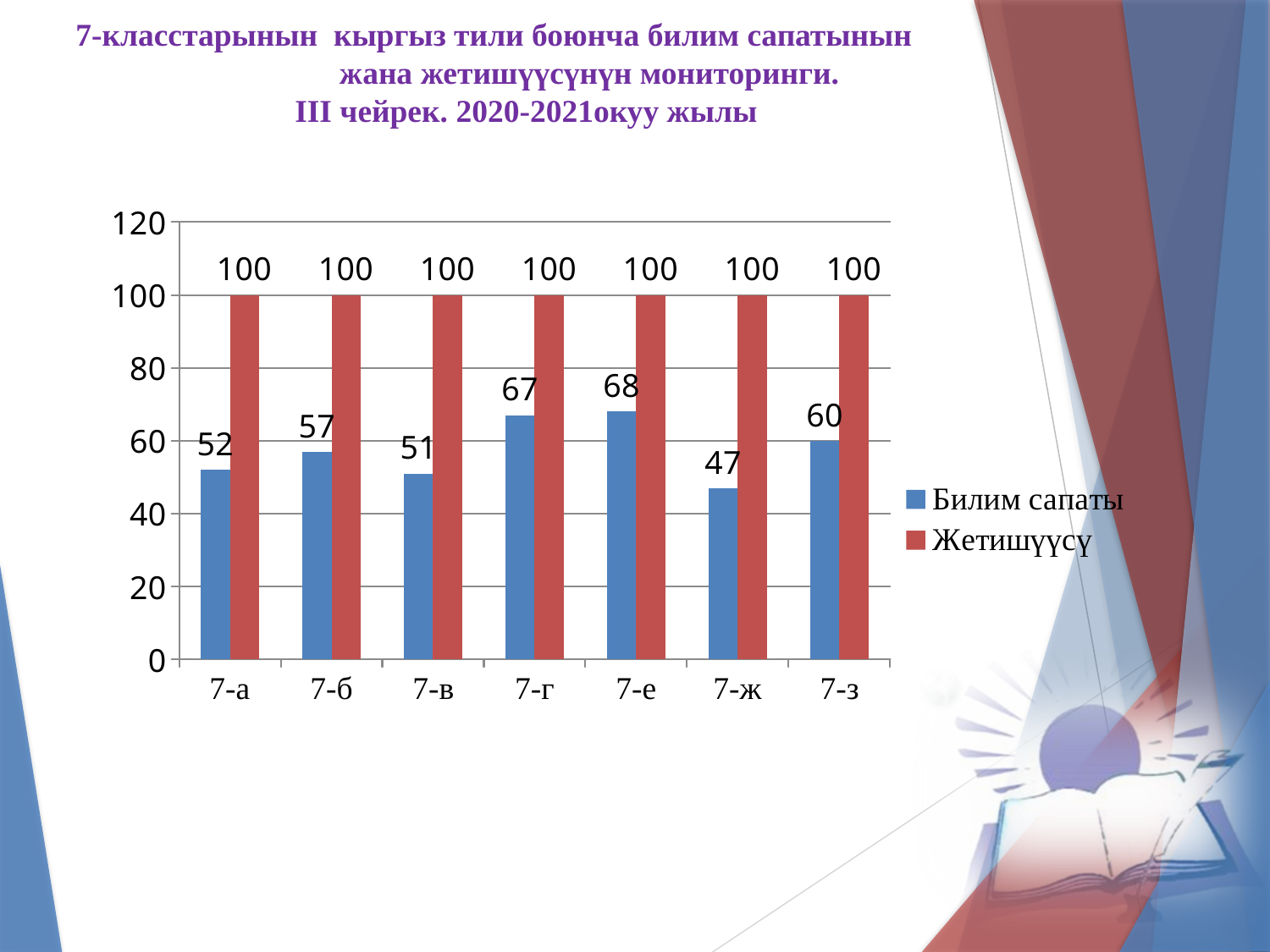
What is the Билим сапаты value for 7-г? 67 Which class has the lowest Билим сапаты value? 7-ж Which class has the highest Билим сапаты value? 7-е What is the Билим сапаты value for 7-ж? 47 Is the Билим сапаты value for 7-в greater or less than 60? less How many classes are shown on the x axis? 7 Which colour represents Жетишүүсү in the chart? red Which is larger, the Билим сапаты value for 7-б or for 7-з? 7-з What is the difference between the Билим сапаты values for 7-е and 7-ж? 21 What kind of chart is shown on the slide? bar chart What is the Жетишүүсү value for 7-б? 100 How many series does the legend list? 2